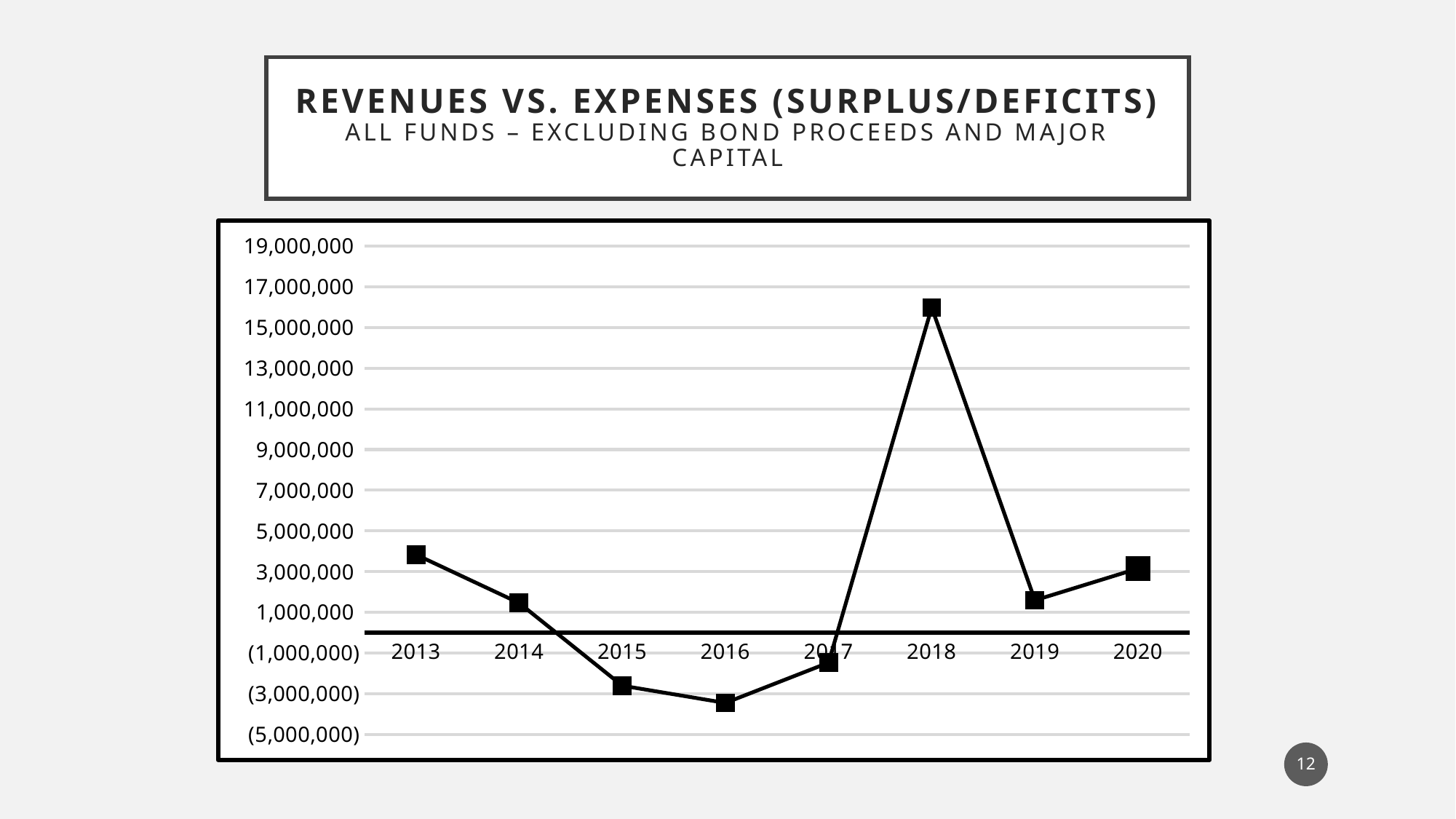
Is the value for 2018 greater or less than 15,000,000? greater Is the value for 2013 greater or less than 3,000,000? greater Which year has the larger value, 2013 or 2014? 2013 Is the value for 2016 greater or less than (3,000,000)? less Which year has the highest value on the chart? 2018 What is the main title of the slide above the chart? Revenues vs. Expenses (Surplus/Deficits) What kind of chart is shown on the slide? line chart Which year has the lowest value on the chart? 2016 Which year has the larger value, 2019 or 2020? 2020 How many years are plotted on the x axis of the chart? 8 Do the values rise or fall from 2013 to 2016? fall